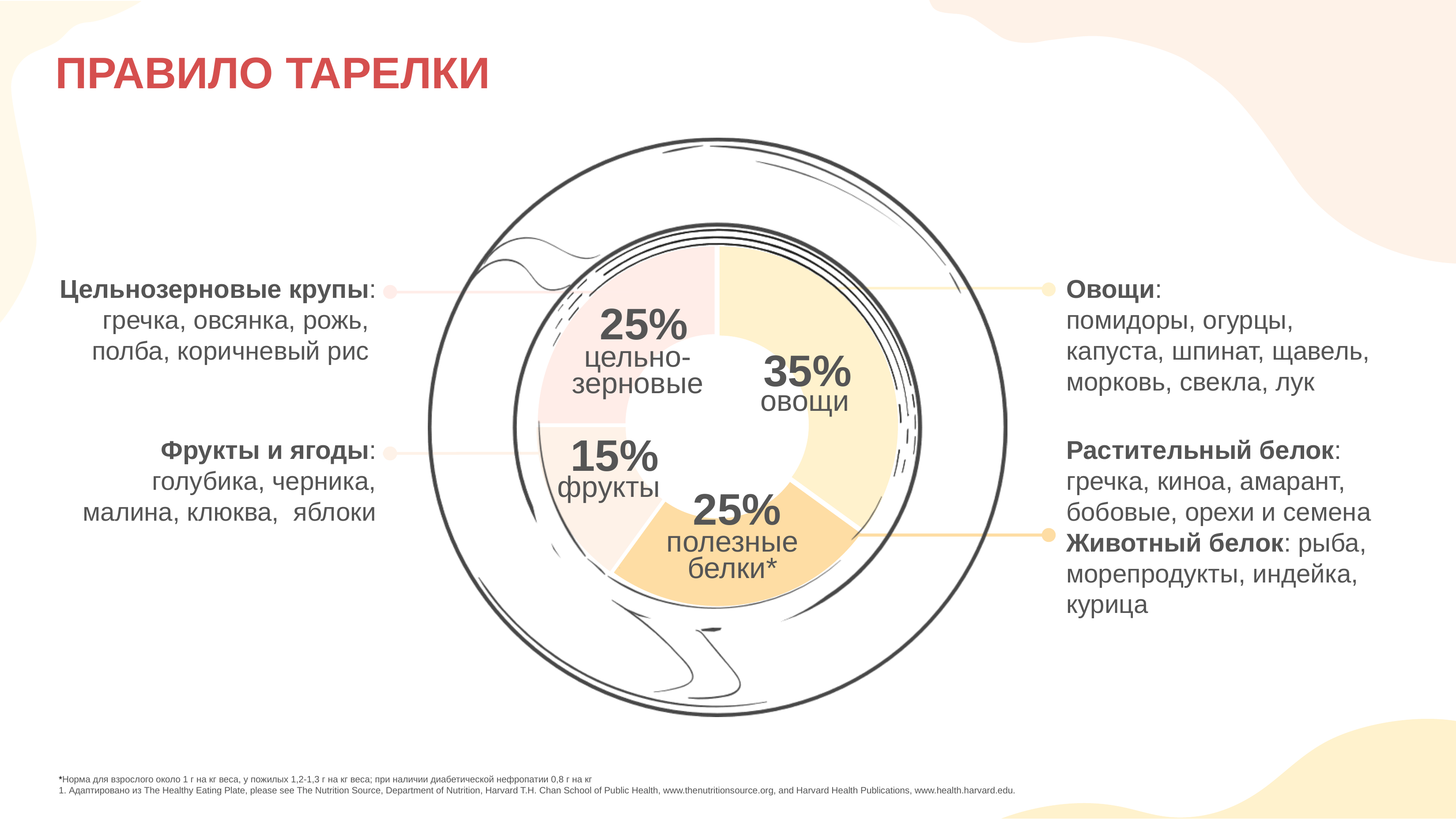
Which segment of the plate has the smallest share? фрукты Which segment of the plate has the largest share? овощи What percentage is shown for the "цельнозерновые" segment? 25% What is the difference in percentage points between the "овощи" and "фрукты" segments? 20% How many segments does the plate chart have? 4 What kind of chart is shown on the slide? doughnut chart What is the combined share of the "цельнозерновые" and "полезные белки" segments? 50% What is the title of the slide containing the chart? ПРАВИЛО ТАРЕЛКИ What percentage is shown for the "полезные белки" segment? 25% What share of the plate does the "овощи" segment represent? 35% What percentage is shown for the "фрукты" segment? 15% Which is larger: the share for "овощи" or the share for "полезные белки"? овощи